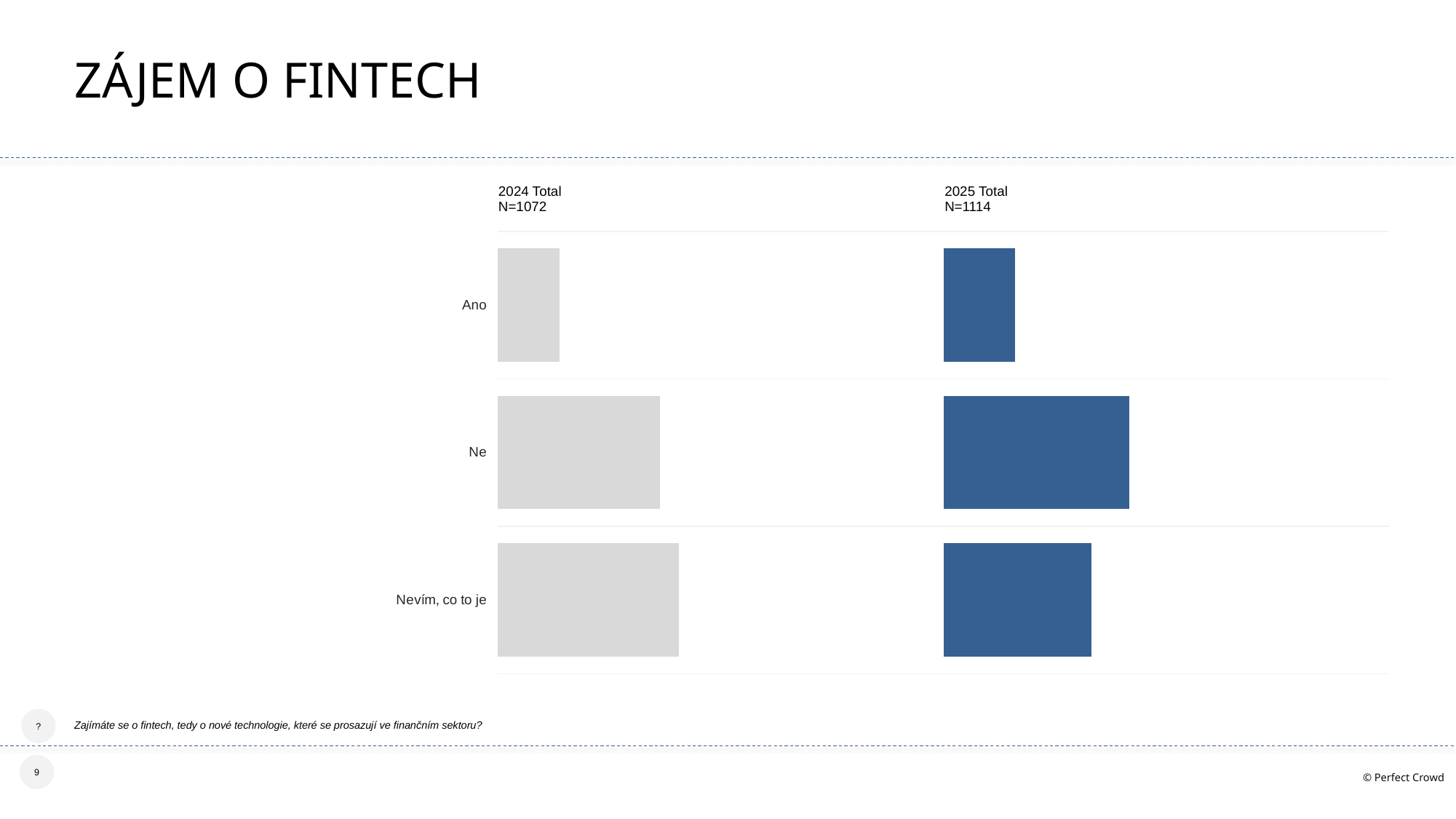
How many response categories are shown in the chart? 3 For the category "Ne", which series has the larger value: 2024 Total or 2025 Total? 2025 Total What kind of chart is shown on the slide? bar chart Which category has the highest value in the 2025 Total series? Ne In the 2025 Total series, which is larger: the value for "Ne" or the value for "Ano"? Ne How many series (survey waves) does the chart show? 2 What is the sample size (N) shown for the 2024 Total series? N=1072 For the category "Nevím, co to je", which series has the larger value: 2024 Total or 2025 Total? 2024 Total What is the title of the slide containing the chart? ZÁJEM O FINTECH Which category has the lowest value in the 2024 Total series? Ano Which category has the lowest value in the 2025 Total series? Ano